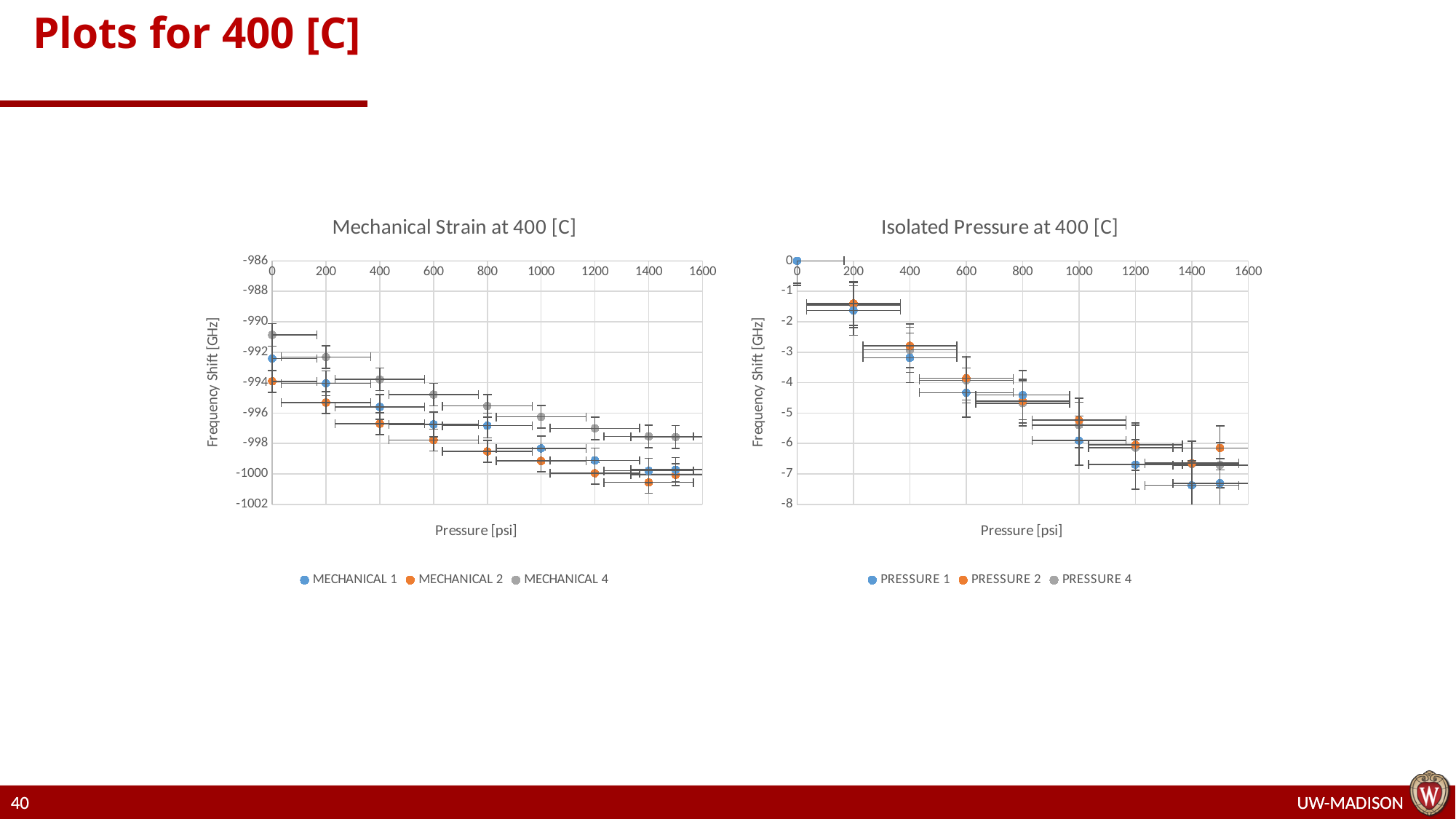
In the 'Mechanical Strain at 400 [C]' chart, at 0 psi, which series has the higher frequency shift: MECHANICAL 1 or MECHANICAL 4? MECHANICAL 4 How many series does the legend of the 'Mechanical Strain at 400 [C]' chart list? 3 In the 'Isolated Pressure at 400 [C]' chart, is the PRESSURE 1 value at 600 psi greater or less than -4? less In the 'Mechanical Strain at 400 [C]' chart, do the frequency shift values rise or fall as pressure increases? fall In the 'Isolated Pressure at 400 [C]' chart, is the PRESSURE 2 value at 200 psi greater or less than -2? greater How many series does the legend of the 'Isolated Pressure at 400 [C]' chart list? 3 In the 'Isolated Pressure at 400 [C]' chart, at 1400 psi, which series has the higher frequency shift: PRESSURE 1 or PRESSURE 2? PRESSURE 2 In the 'Isolated Pressure at 400 [C]' chart, do the frequency shift values rise or fall as pressure increases? fall What kind of chart is the 'Mechanical Strain at 400 [C]' chart? scatter chart In the 'Mechanical Strain at 400 [C]' chart, is the MECHANICAL 2 value at 1400 psi greater or less than -1000? less What is the y-axis label of the 'Isolated Pressure at 400 [C]' chart? Frequency Shift [GHz]